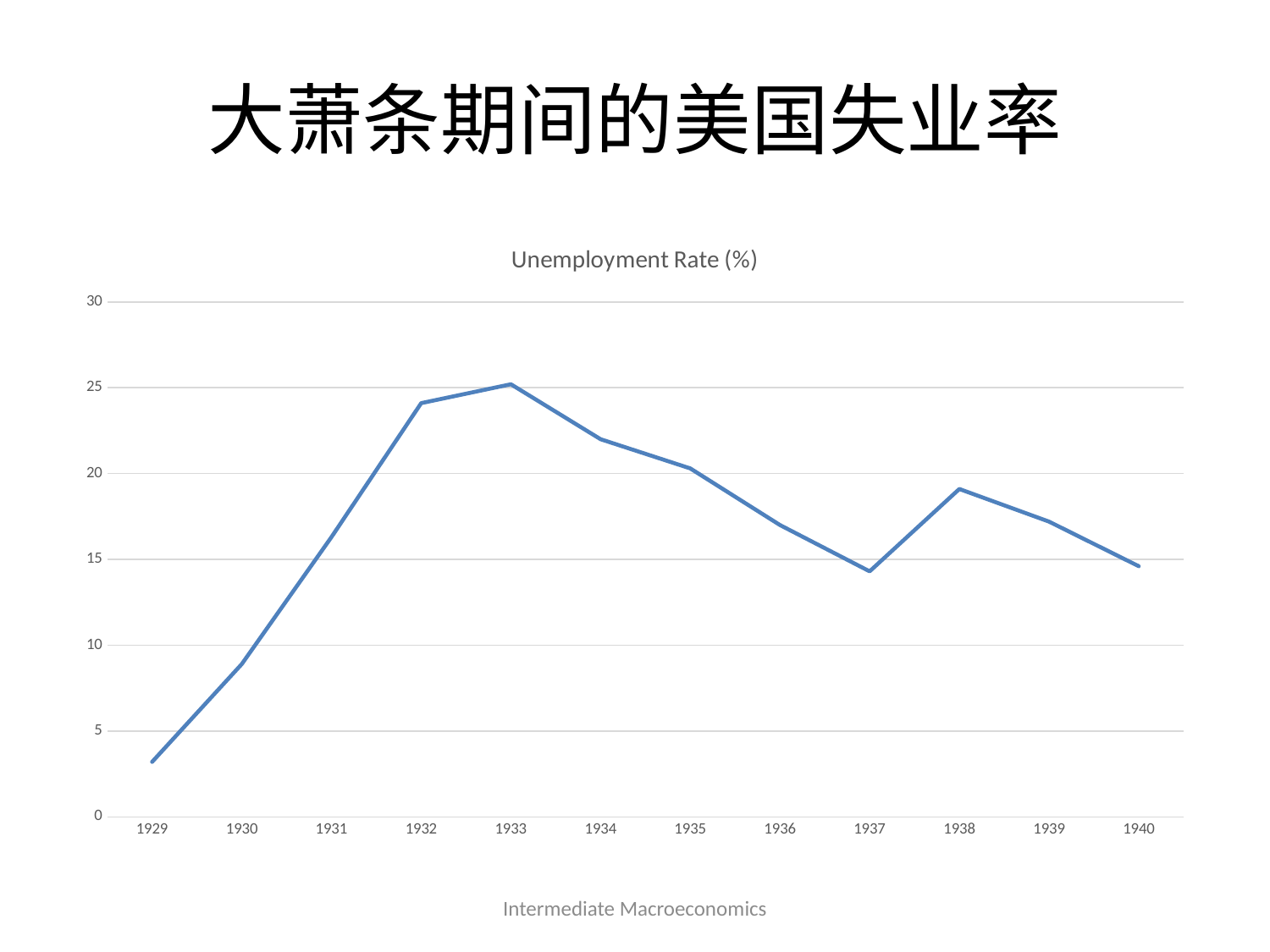
Which year has the lowest unemployment rate? 1929 Does the unemployment rate rise or fall from 1929 to 1933? Rise What kind of chart is shown on the slide? Line chart Which year has a higher unemployment rate, 1932 or 1938? 1932 How many years are plotted on the x axis? 12 Which year has a higher unemployment rate, 1937 or 1938? 1938 Is the unemployment rate for 1932 greater or less than 20? greater What is the title of the chart? Unemployment Rate (%) Is the unemployment rate for 1937 greater or less than 15? less Which year has the highest unemployment rate? 1933 Is the unemployment rate for 1930 greater or less than 10? less